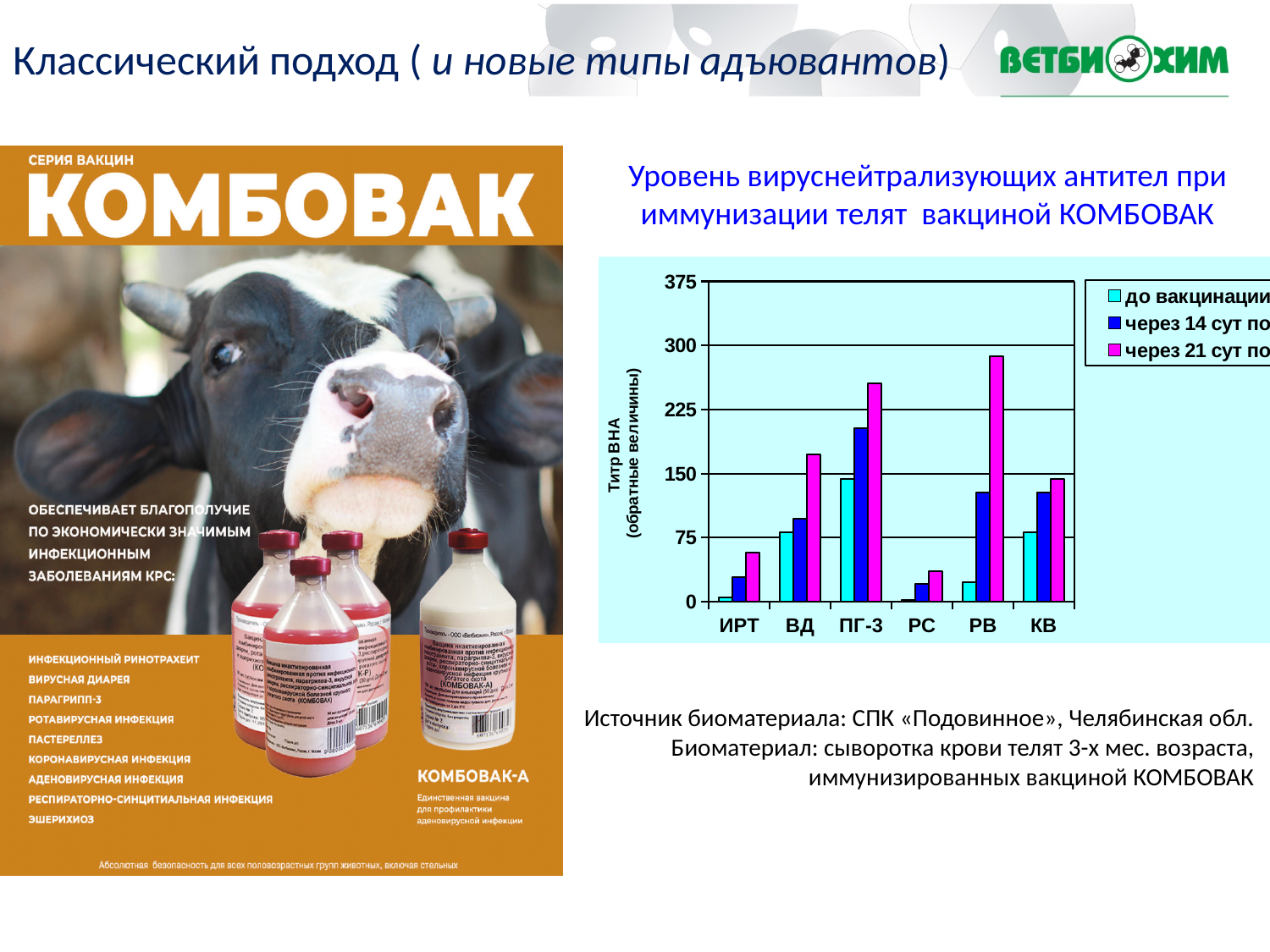
Which is larger for ВД: the 'через 14 сут' value or the 'через 21 сут' value? через 21 сут How many categories are shown on the x axis of the chart? 6 How many series does the chart's legend list? 3 Which category has the highest value for the 'до вакцинации' series? ПГ-3 Is the value for РВ in the 'через 21 сут' series greater or less than 225? greater Which is larger in the 'через 21 сут' series: ПГ-3 or КВ? ПГ-3 What is the first entry listed in the chart's legend? до вакцинации Which category has the highest value for the 'через 21 сут' series? РВ What kind of chart is shown on the slide? bar chart Which category has the lowest value for the 'через 21 сут' series? РС Is the value for ПГ-3 in the 'через 14 сут' series greater or less than 150? greater Is the value for РС in the 'через 21 сут' series greater or less than 75? less